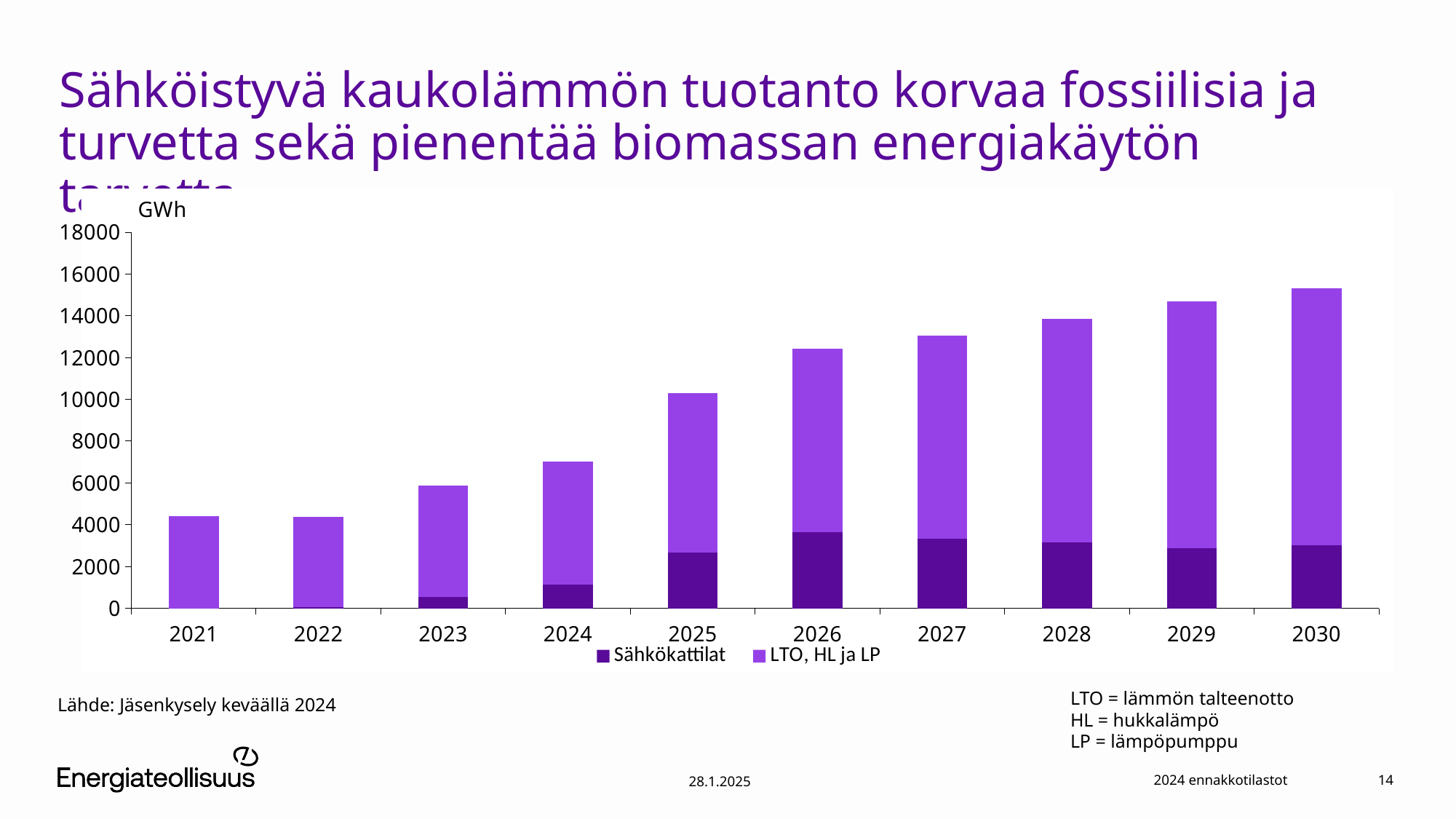
What are the two series named in the chart legend? Sähkökattilat; LTO, HL ja LP Is the total value for 2030 greater or less than 14000? greater How many series does the chart legend list? 2 Which year has the larger total bar, 2021 or 2030? 2030 Is the Sähkökattilat value for 2024 greater or less than 2000? less Is the total value for 2024 greater or less than 8000? less How many years are shown on the x axis of the chart? 10 Do the total bar heights generally rise or fall from 2021 to 2030? Rise What unit is shown at the top of the y axis? GWh What kind of chart is shown on the slide? Stacked bar chart Which year has the highest total bar in the chart? 2030